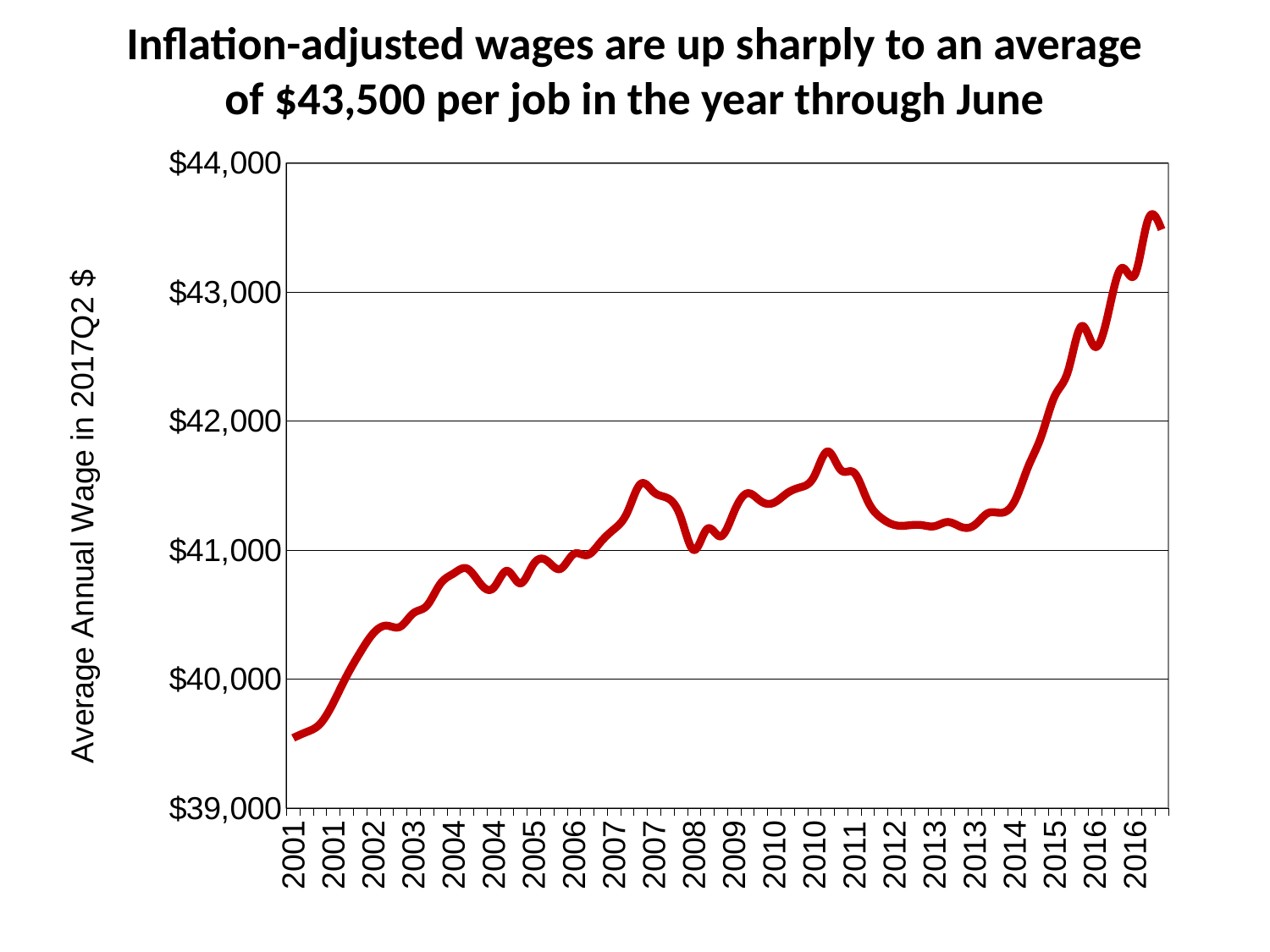
Is the value in 2012 greater or less than $41,000? greater What kind of chart is shown on the slide? line chart Is the value in 2005 greater or less than $41,000? less Is the value at the end of 2016 greater or less than $43,000? greater In which year does the line reach its lowest value? 2001 What is the label on the vertical axis? Average Annual Wage in 2017Q2 $ Overall, do the values rise or fall from 2001 to 2016? rise What colour is the line in the chart? red